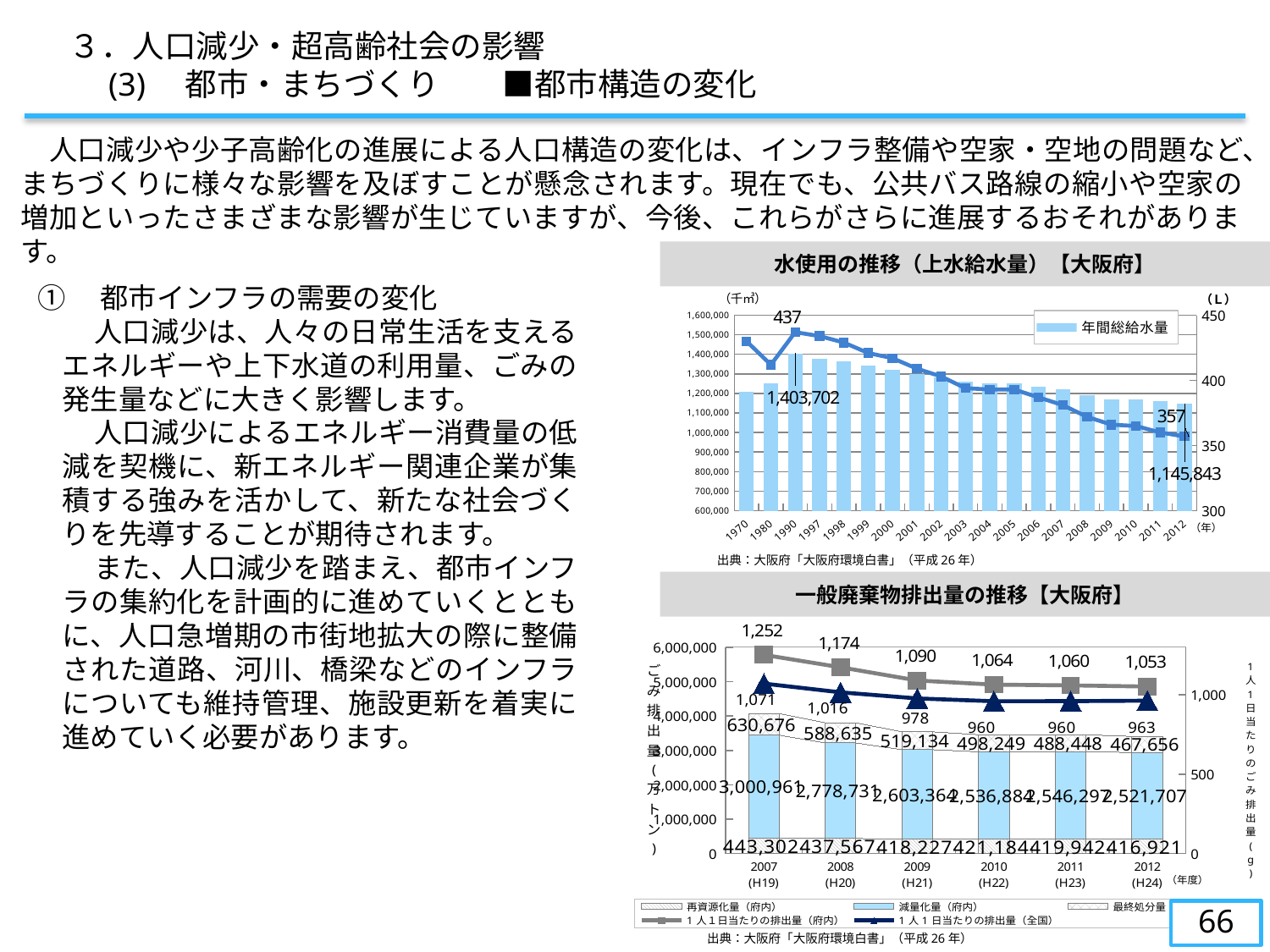
In the chart titled 水使用の推移（上水給水量）【大阪府】, what is the labelled value of the line (per-person daily supply, L) in 1990? 437 In the chart titled 一般廃棄物排出量の推移【大阪府】, how many series does the legend list? 5 In the chart titled 水使用の推移（上水給水量）【大阪府】, what is the labelled 年間総給水量 value for 2012? 1,145,843 In the chart titled 水使用の推移（上水給水量）【大阪府】, what is the labelled value of the line (per-person daily supply, L) in 2012? 357 In the chart titled 水使用の推移（上水給水量）【大阪府】, by how much did the labelled per-person daily value (L) fall from 1990 to 2012? 80 In the chart titled 一般廃棄物排出量の推移【大阪府】, what is the difference between the 1人1日当たりの排出量（府内） values for 2007 and 2012? 199 In the chart titled 水使用の推移（上水給水量）【大阪府】, how many years are shown on the x axis? 19 In the chart titled 一般廃棄物排出量の推移【大阪府】, what is the value of 1人1日当たりの排出量（全国） in 2009? 978 In the chart titled 水使用の推移（上水給水量）【大阪府】, what is the labelled 年間総給水量 value for 1990? 1,403,702 In the chart titled 一般廃棄物排出量の推移【大阪府】, which is larger in 2007: 1人1日当たりの排出量（府内） or 1人1日当たりの排出量（全国）? 1人1日当たりの排出量（府内） In the chart titled 一般廃棄物排出量の推移【大阪府】, what is the value of 1人1日当たりの排出量（府内） in 2007? 1,252 In the chart titled 水使用の推移（上水給水量）【大阪府】, do the bar values rise or fall from 1997 to 2012? fall